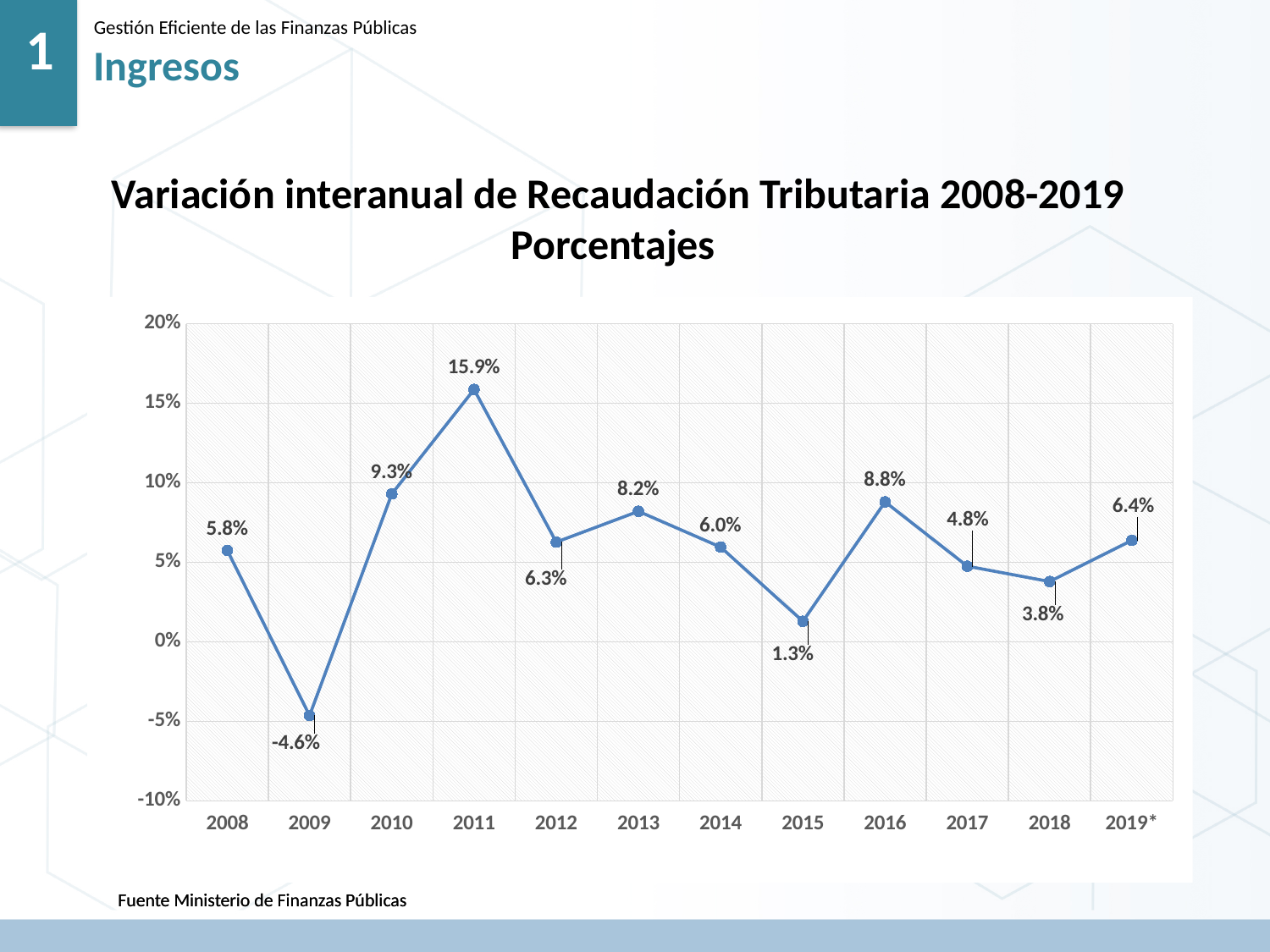
What is the value for 2011? 15.9% What is the difference between the values for 2011 and 2010? 6.6% What is the value for 2015? 1.3% What kind of chart is shown? line chart Is the value for 2010 greater or less than 5%? greater How many years are plotted on the x axis? 12 What is the value for 2019*? 6.4% Do the values rise or fall from 2016 to 2018? fall Which is larger, the value for 2016 or the value for 2013? 2016 Which year has the highest value? 2011 Which year has the lowest value? 2009 What is the value for 2009? -4.6%